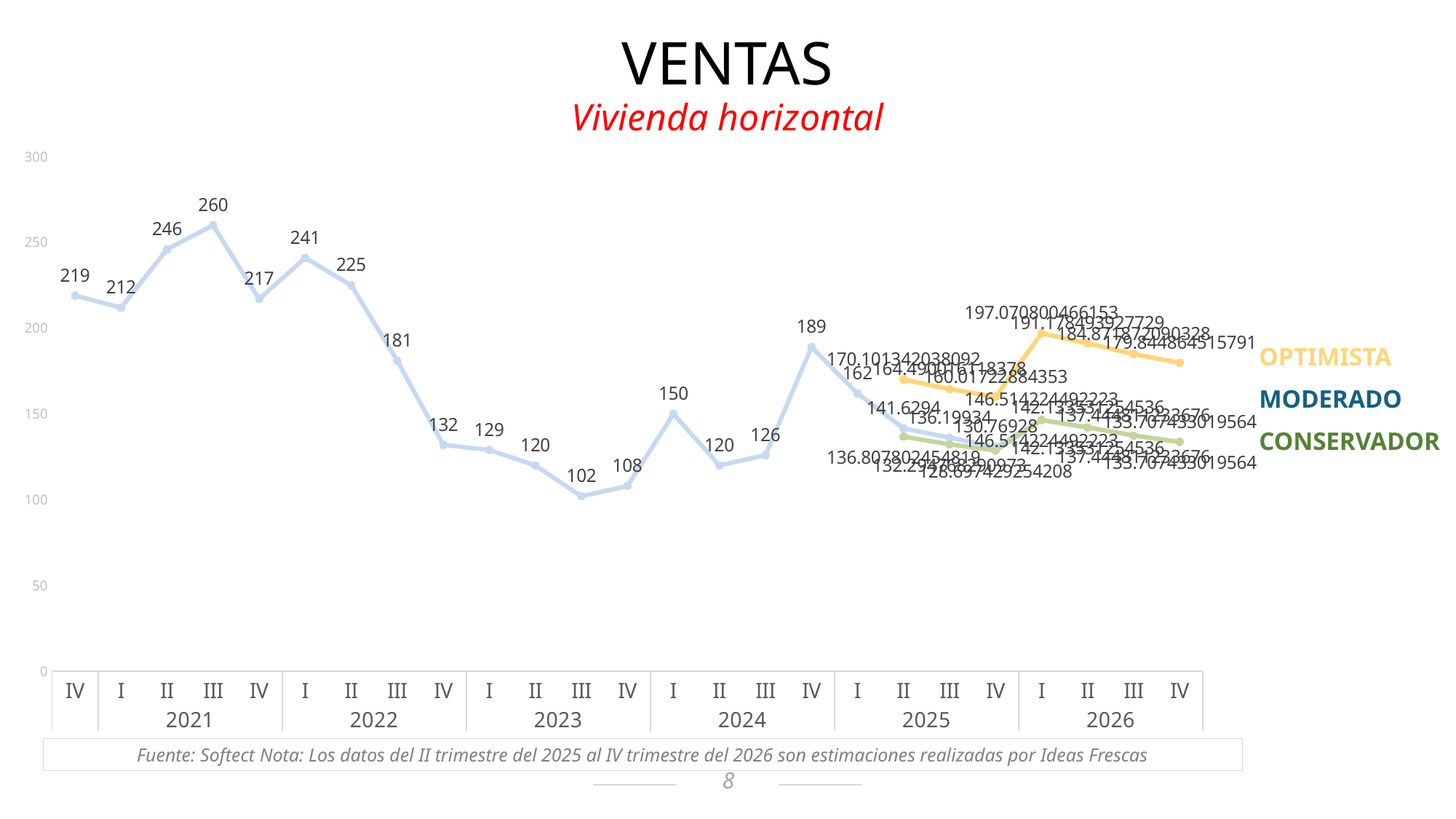
Which quarter has the highest sales value on the chart? III 2021 Do the sales values rise or fall from quarter I of 2022 to quarter IV of 2022? fall What type of chart is shown on the slide? line chart What is the difference between the sales value in quarter III of 2021 and quarter IV of 2021? 43 What is the sales value for quarter III of 2023? 102 Which quarter has the lowest sales value on the chart? III 2023 Which is larger, the sales value in quarter I of 2024 or quarter I of 2025? I 2025 What is the sales value for quarter IV of 2024? 189 What are the three scenario labels shown to the right of the chart? OPTIMISTA, MODERADO, CONSERVADOR What is the sales value for quarter III of 2021? 260 What is the sales value for quarter I of 2022? 241 What is the subtitle shown in red below the chart title VENTAS? Vivienda horizontal